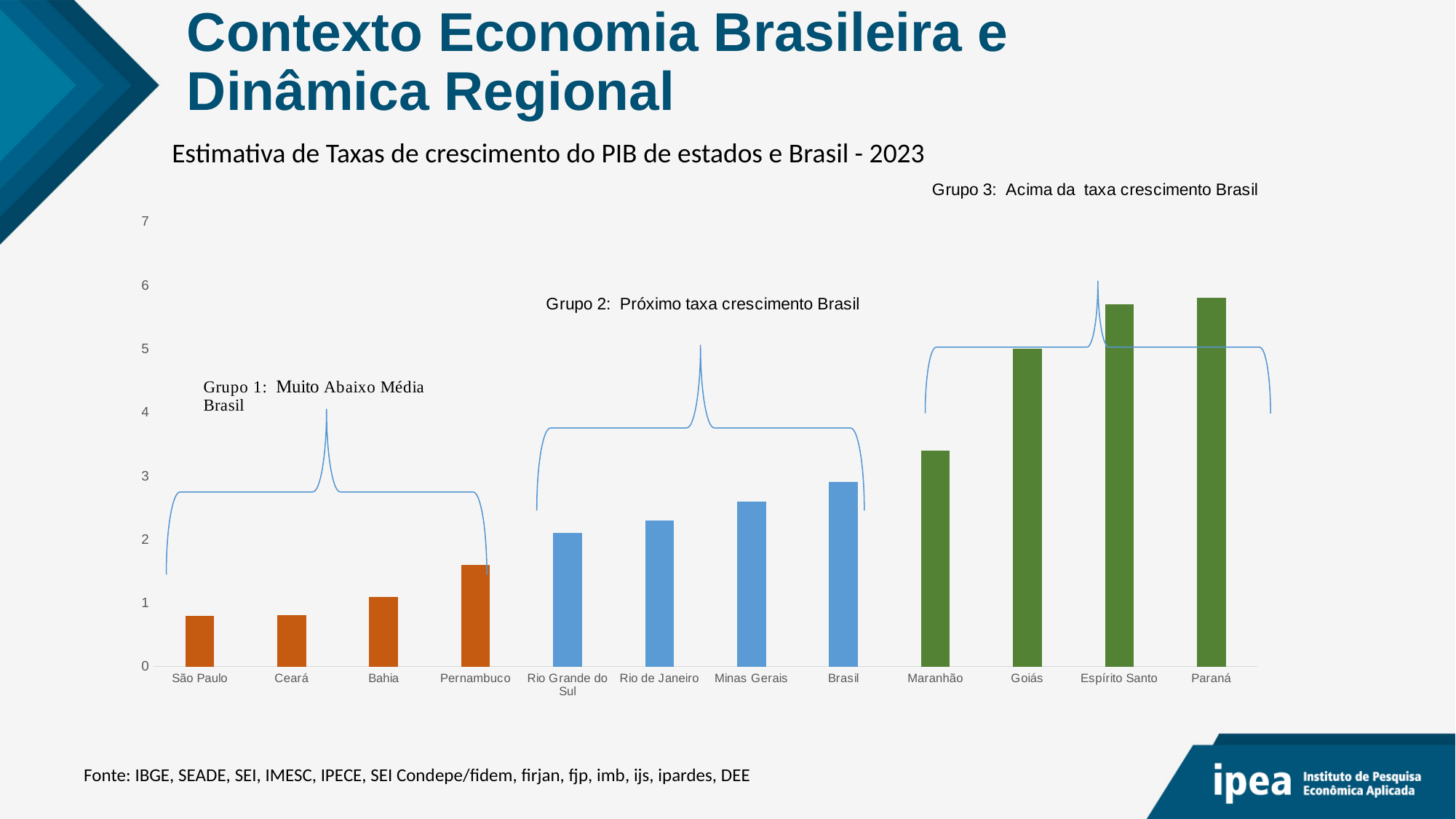
Is the value for Pernambuco greater or less than 2? less What kind of chart is shown on the slide? bar chart What is the title of the chart? Estimativa de Taxas de crescimento do PIB de estados e Brasil - 2023 Is the value for São Paulo greater or less than 1? less Is the value for Maranhão greater or less than 3? greater Do the bar values rise or fall from left to right along the x axis? rise Which has the larger value, Bahia or Minas Gerais? Minas Gerais Which has the larger value, Brasil or Maranhão? Maranhão How many states/categories are plotted on the chart? 12